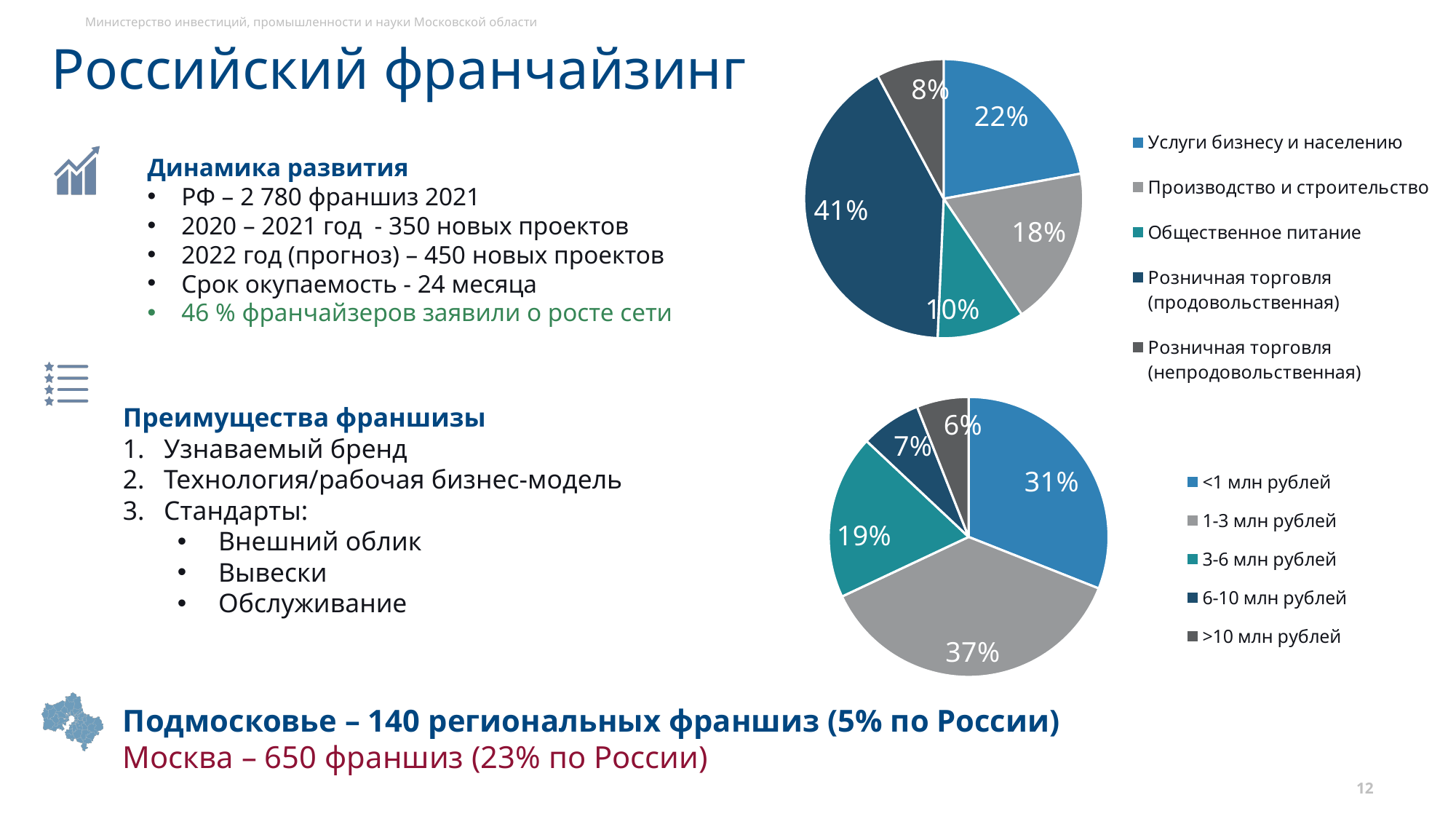
In the top pie chart, what is the difference between the shares of Услуги бизнесу и населению and Производство и строительство? 4% How many categories does the legend of the top pie chart list? 5 In the top pie chart, what share is shown for Розничная торговля (продовольственная)? 41% In the top pie chart, which category has the smallest share? Розничная торговля (непродовольственная) In the top pie chart, what share is shown for Общественное питание? 10% In the bottom pie chart, which category has the smallest share? >10 млн рублей What type of chart is the bottom chart on the slide? Pie chart In the bottom pie chart, which is larger: the share for <1 млн рублей or the share for 3-6 млн рублей? <1 млн рублей In the bottom pie chart, which category has the largest share? 1-3 млн рублей In the bottom pie chart, what share is shown for 1-3 млн рублей? 37% In the top pie chart, which category has the largest share? Розничная торговля (продовольственная) In the bottom pie chart, what share is shown for 6-10 млн рублей? 7%